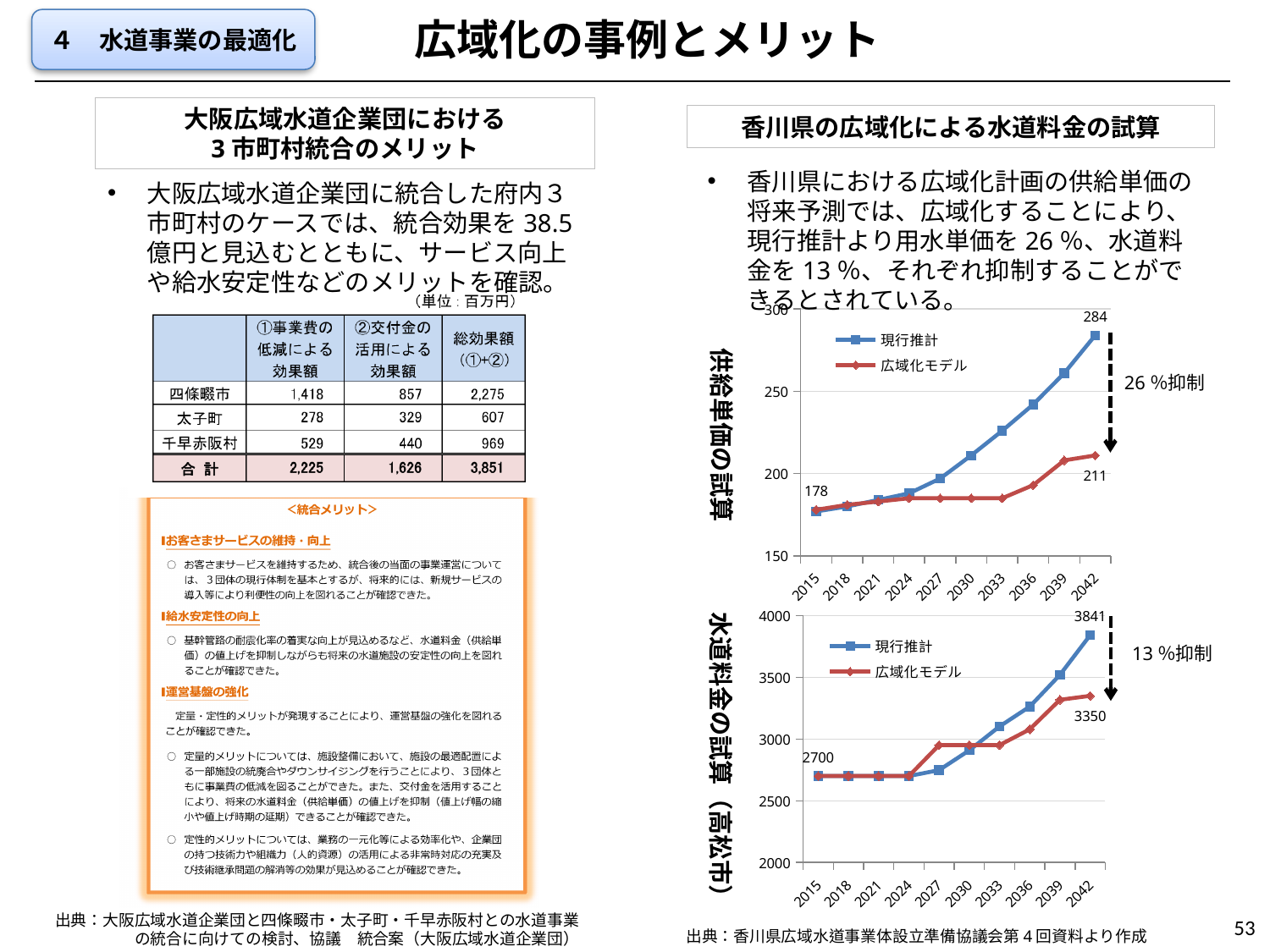
In the top chart (供給単価の試算), does the 現行推計 series rise or fall from 2015 to 2042? rise In the bottom chart (水道料金の試算（高松市）), what is the value of 広域化モデル in 2042? 3350 What kind of chart is the bottom chart (水道料金の試算（高松市）)? line chart In the bottom chart (水道料金の試算（高松市）), what is the difference between 現行推計 and 広域化モデル in 2042? 491 In the top chart (供給単価の試算), what is the difference between 現行推計 and 広域化モデル in 2042? 73 How many series does the legend of the top chart (供給単価の試算) list? 2 In the top chart (供給単価の試算), is the value of 現行推計 in 2036 greater or less than 200? greater In the top chart (供給単価の試算), what is the value of 現行推計 in 2042? 284 In the top chart (供給単価の試算), what is the starting value in 2015? 178 In the top chart (供給単価の試算), what is the value of 広域化モデル in 2042? 211 In the bottom chart (水道料金の試算（高松市）), what is the value of 現行推計 in 2042? 3841 In the bottom chart (水道料金の試算（高松市）), which series is higher in 2042, 現行推計 or 広域化モデル? 現行推計